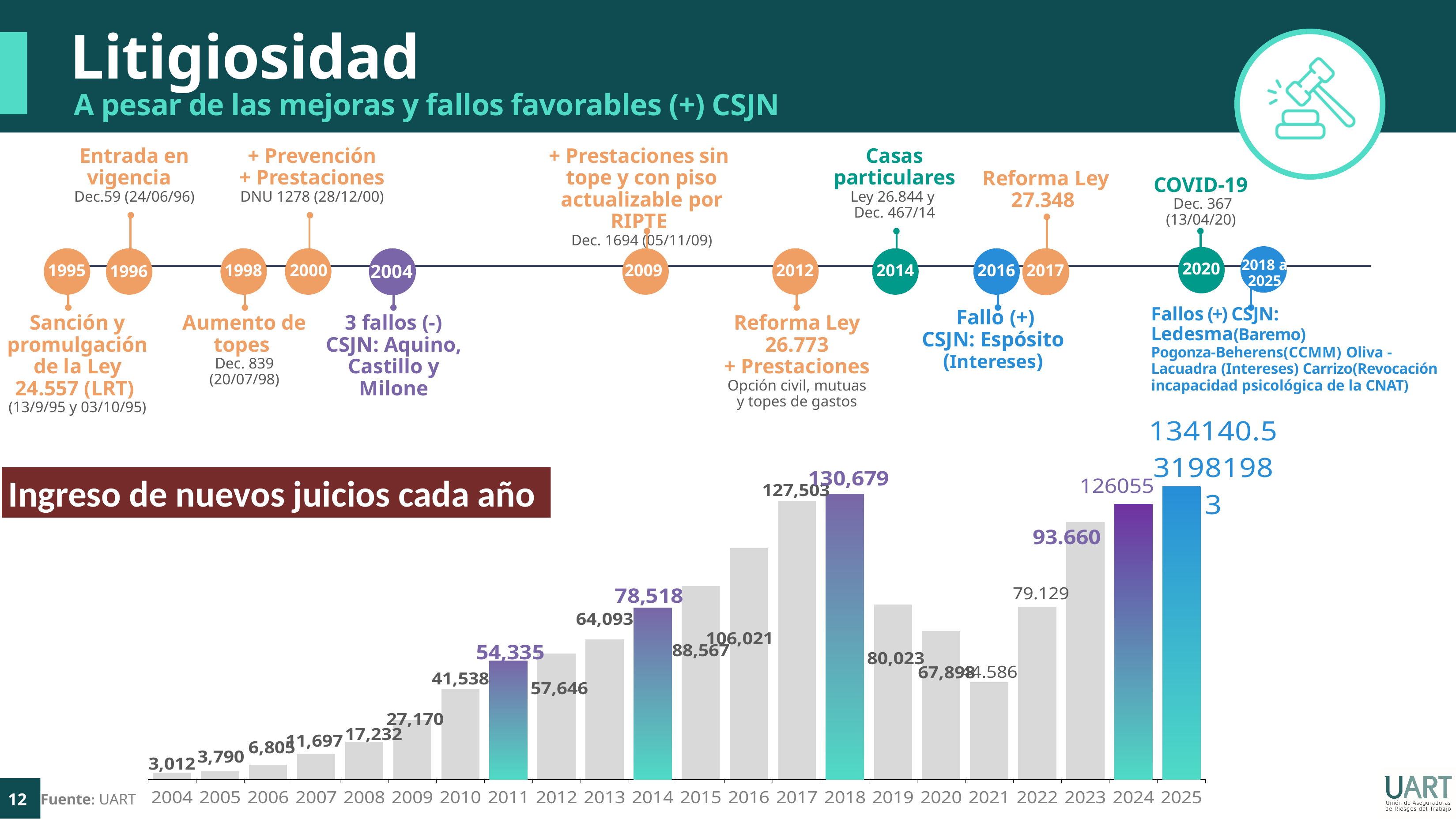
What is the value for 2017 in the chart 'Ingreso de nuevos juicios cada año'? 127,503 In the chart 'Ingreso de nuevos juicios cada año', do the values rise or fall from 2004 to 2018? Rise In the chart 'Ingreso de nuevos juicios cada año', what is the difference between the values for 2018 and 2017? 3,176 Which year has the highest bar in the chart 'Ingreso de nuevos juicios cada año'? 2025 What is the value for 2018 in the chart 'Ingreso de nuevos juicios cada año'? 130,679 How many years are shown on the x axis of the chart 'Ingreso de nuevos juicios cada año'? 22 What kind of chart is 'Ingreso de nuevos juicios cada año'? Bar chart What is the value for 2004 in the chart 'Ingreso de nuevos juicios cada año'? 3,012 What is the value for 2023 in the chart 'Ingreso de nuevos juicios cada año'? 93.660 In the chart 'Ingreso de nuevos juicios cada año', which year has the larger value, 2016 or 2019? 2016 Which year has the lowest value in the chart 'Ingreso de nuevos juicios cada año'? 2004 What is the value for 2014 in the chart 'Ingreso de nuevos juicios cada año'? 78,518